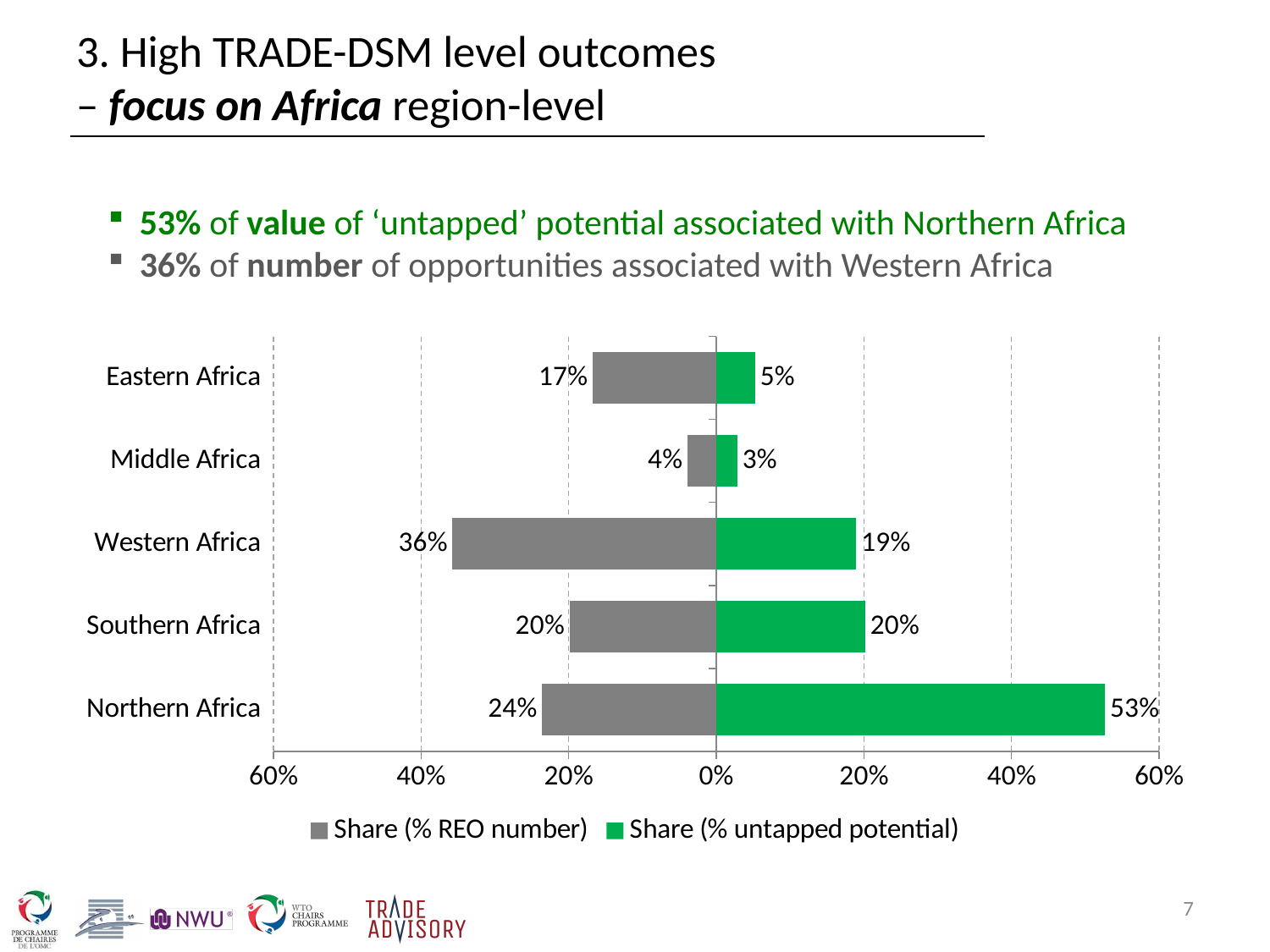
Which region has the highest Share (% untapped potential)? Northern Africa How many regions are shown on the chart? 5 What is the Share (% untapped potential) for Middle Africa? 3% Which region has the lowest Share (% REO number)? Middle Africa What is the difference between the Share (% untapped potential) and the Share (% REO number) for Northern Africa? 29% What is the Share (% REO number) for Western Africa? 36% What is the Share (% REO number) for Eastern Africa? 17% Which colour represents Share (% untapped potential) in the chart? Green Which is larger for Western Africa: the Share (% REO number) or the Share (% untapped potential)? Share (% REO number) What kind of chart is shown on the slide? Bar chart What is the Share (% untapped potential) for Northern Africa? 53% How many series does the legend list? 2